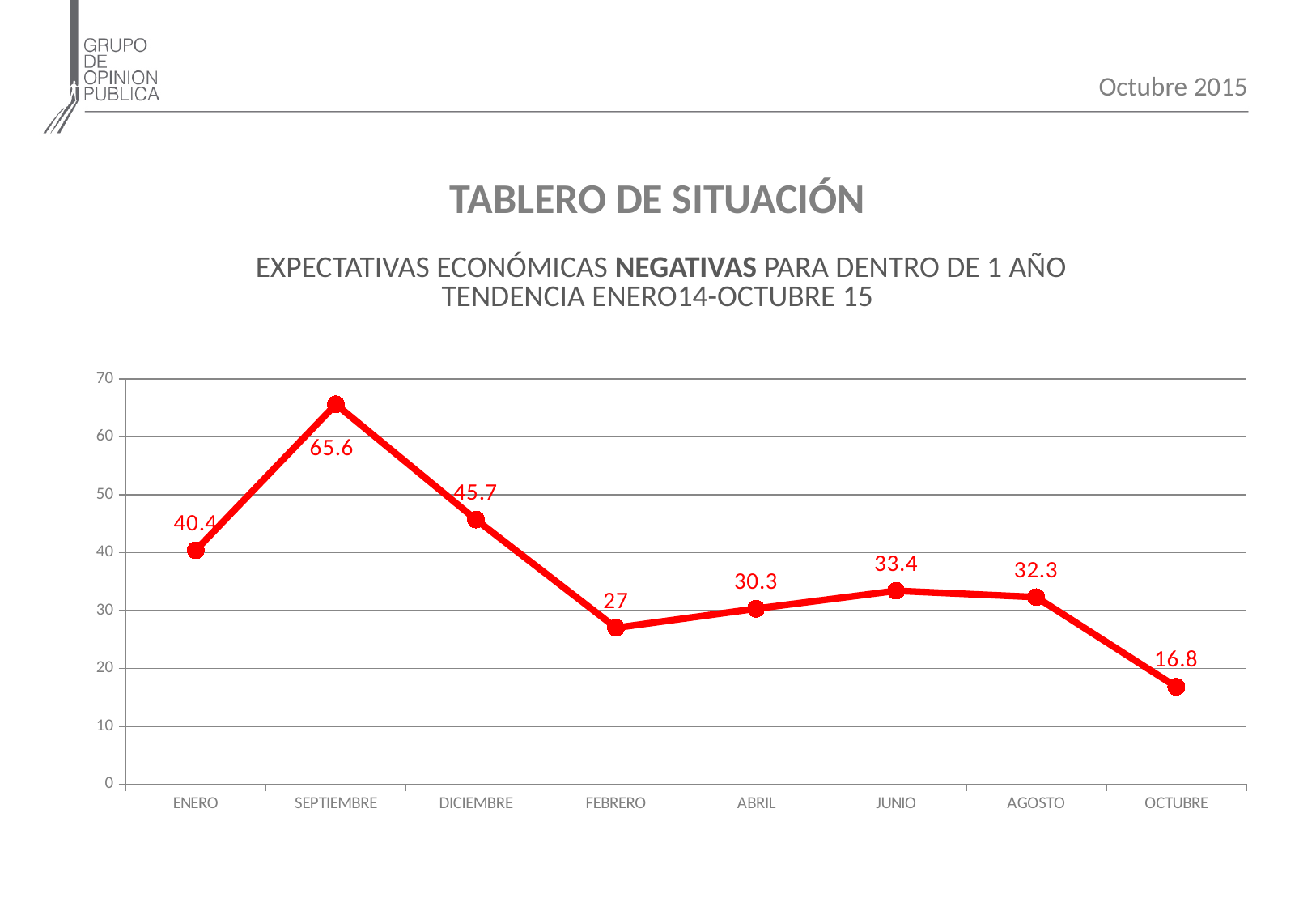
What is the value for SEPTIEMBRE? 65.6 How many data points are plotted on the chart? 8 Is the value for ENERO greater or less than 50? less What is the difference between the values for SEPTIEMBRE and DICIEMBRE? 19.9 Do the values rise or fall from AGOSTO to OCTUBRE? fall Which is larger, the value for JUNIO or the value for ABRIL? JUNIO What kind of chart is shown on the slide? line chart What is the value for FEBRERO? 27 What is the value for OCTUBRE? 16.8 Which category has the lowest value? OCTUBRE Which category has the highest value? SEPTIEMBRE What colour is the line on the chart? red